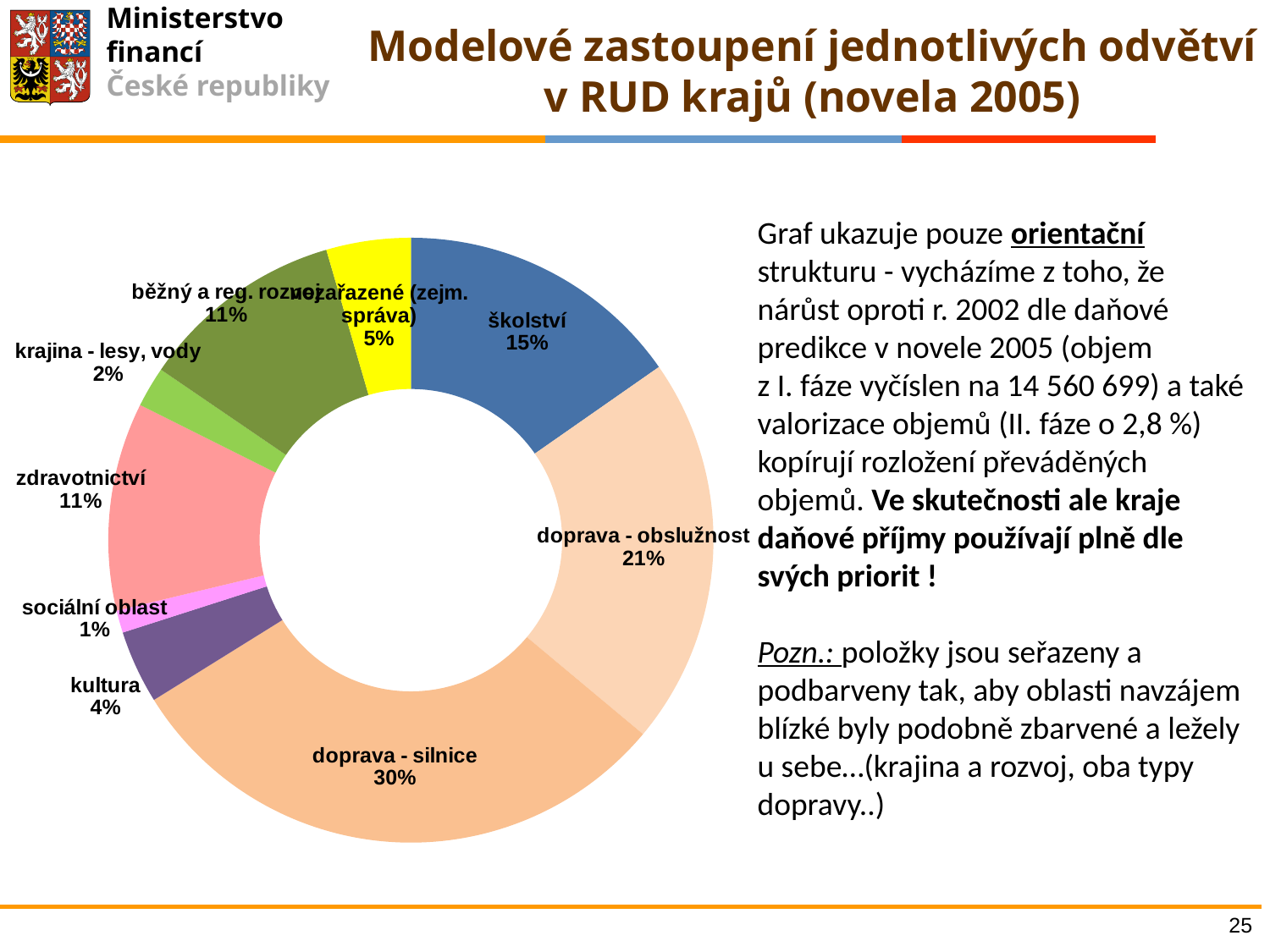
What is the value shown for "školství"? 15% What is the value for "nezařazené (zejm. správa)"? 5% How many categories are shown in the chart? 9 What share of the chart does "doprava - silnice" represent? 30% What kind of chart is shown on the slide? doughnut (pie) chart Which is larger, the share for "kultura" or the share for "krajina - lesy, vody"? kultura Which category has the largest share of the chart? doprava - silnice What is the difference in percentage points between "doprava - silnice" and "doprava - obslužnost"? 9 What percentage is shown for "zdravotnictví"? 11% Which category has the smallest share of the chart? sociální oblast What is the combined share of the two "doprava" categories? 51% What colour is the "školství" slice? blue